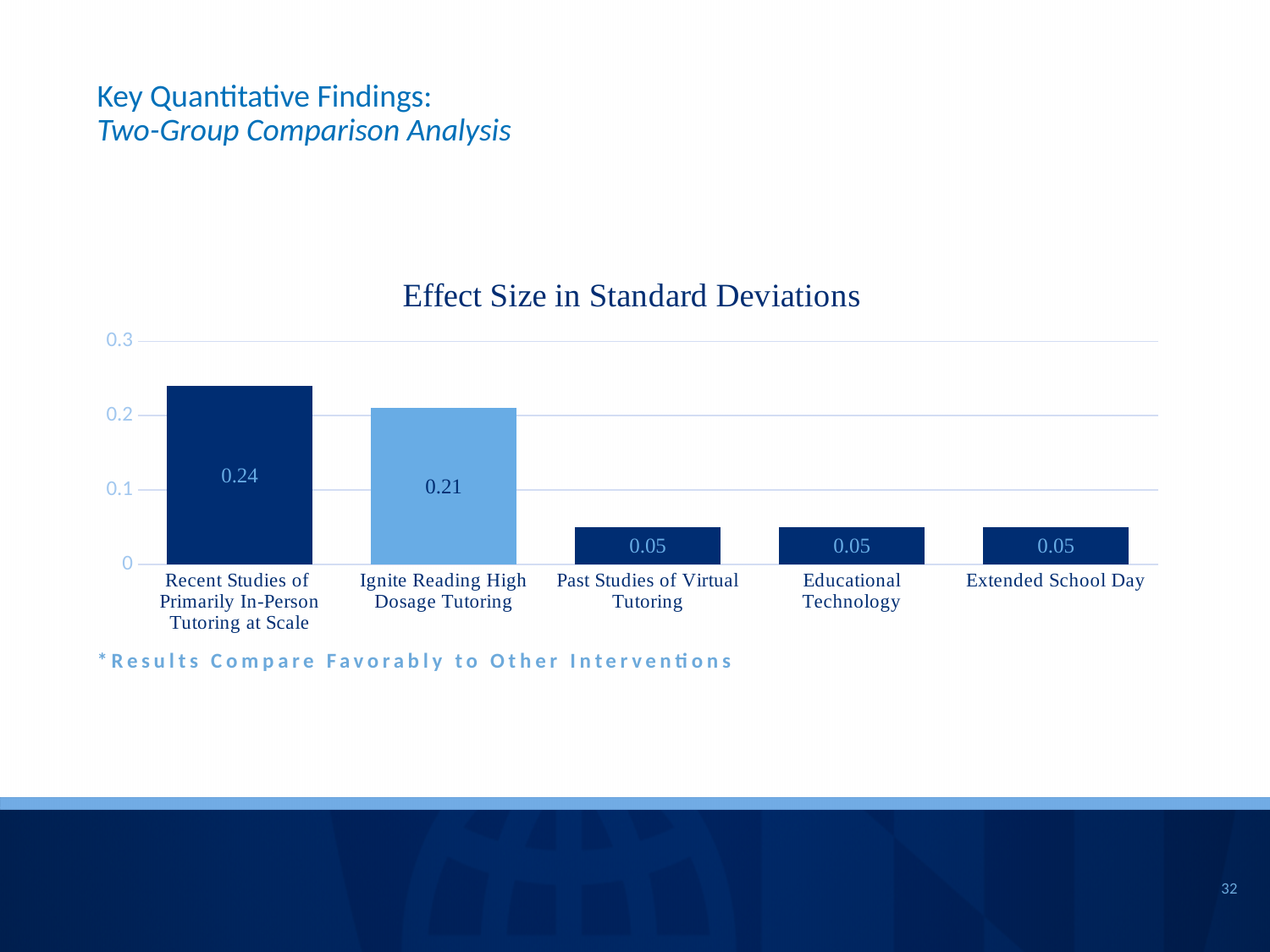
What is the effect size for Educational Technology? 0.05 Is the effect size for Ignite Reading High Dosage Tutoring greater or less than 0.2? greater What is the effect size for Recent Studies of Primarily In-Person Tutoring at Scale? 0.24 Which category has the highest effect size? Recent Studies of Primarily In-Person Tutoring at Scale Which has a larger effect size, Ignite Reading High Dosage Tutoring or Extended School Day? Ignite Reading High Dosage Tutoring What is the effect size for Ignite Reading High Dosage Tutoring? 0.21 What is the title of the chart? Effect Size in Standard Deviations Is the effect size for Past Studies of Virtual Tutoring greater or less than 0.1? less What is the difference in effect size between Ignite Reading High Dosage Tutoring and Past Studies of Virtual Tutoring? 0.16 What is the difference in effect size between Recent Studies of Primarily In-Person Tutoring at Scale and Ignite Reading High Dosage Tutoring? 0.03 How many categories are shown in the chart? 5 What type of chart is shown on the slide? Bar chart